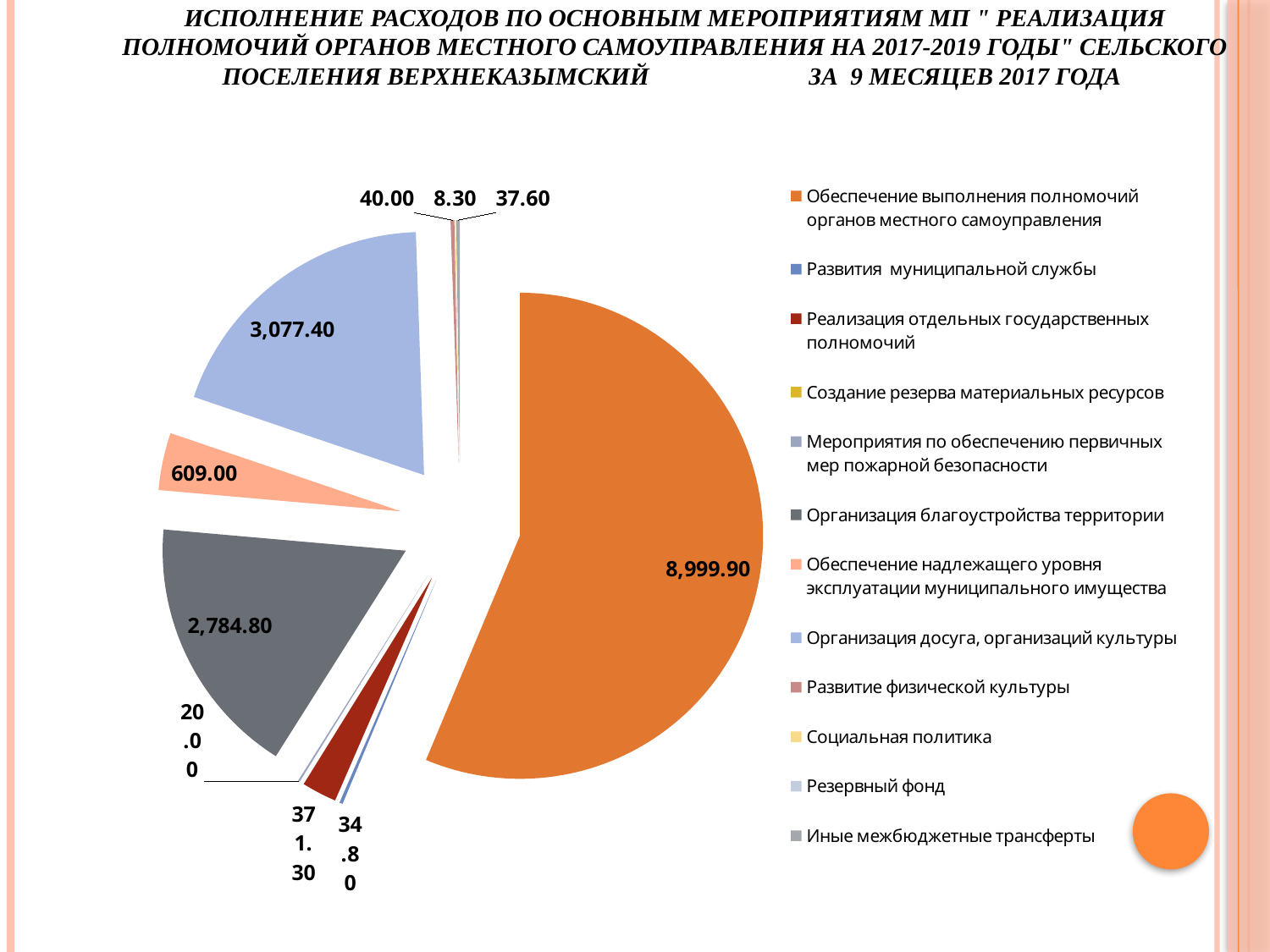
What type of chart is shown on the slide? pie chart What is the value shown for Развития муниципальной службы? 34.80 What is the smallest data label printed on the pie chart? 8.30 What is the value shown for Реализация отдельных государственных полномочий? 371.30 Which category has the largest slice in the pie chart? Обеспечение выполнения полномочий органов местного самоуправления What is the value of the largest slice in the pie chart? 8,999.90 How many categories does the legend of the pie chart list? 12 Which is larger: the value for Обеспечение надлежащего уровня эксплуатации муниципального имущества or for Реализация отдельных государственных полномочий? Обеспечение надлежащего уровня эксплуатации муниципального имущества What is the value shown for Организация благоустройства территории? 2,784.80 What is the value shown for Обеспечение надлежащего уровня эксплуатации муниципального имущества? 609.00 What is the difference between the values for Организация досуга, организаций культуры and Организация благоустройства территории? 292.60 What is the value shown for Организация досуга, организаций культуры? 3,077.40